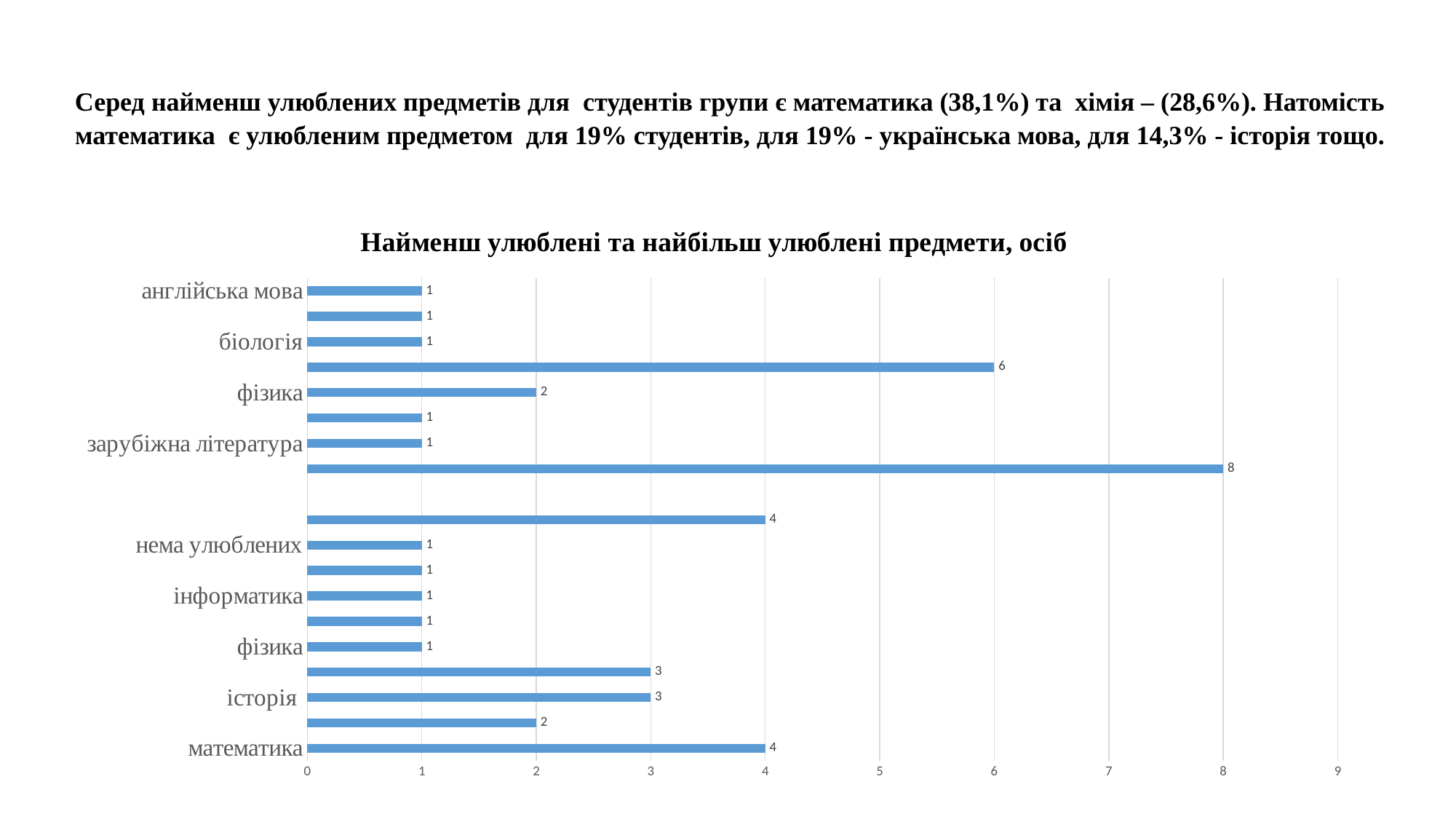
What kind of chart is shown on the slide? bar chart What is the difference between the value for математика and the value for історія? 1 What is the largest value labeled on any bar in the chart? 8 What is the value for історія? 3 What is the value for біологія? 1 Which is larger, the value for історія or the value for біологія? історія Which is larger, the value for математика or the value for історія? математика What is the value for англійська мова? 1 What is the value for математика? 4 What is the value for зарубіжна література? 1 What is the value for нема улюблених? 1 What is the value for інформатика? 1